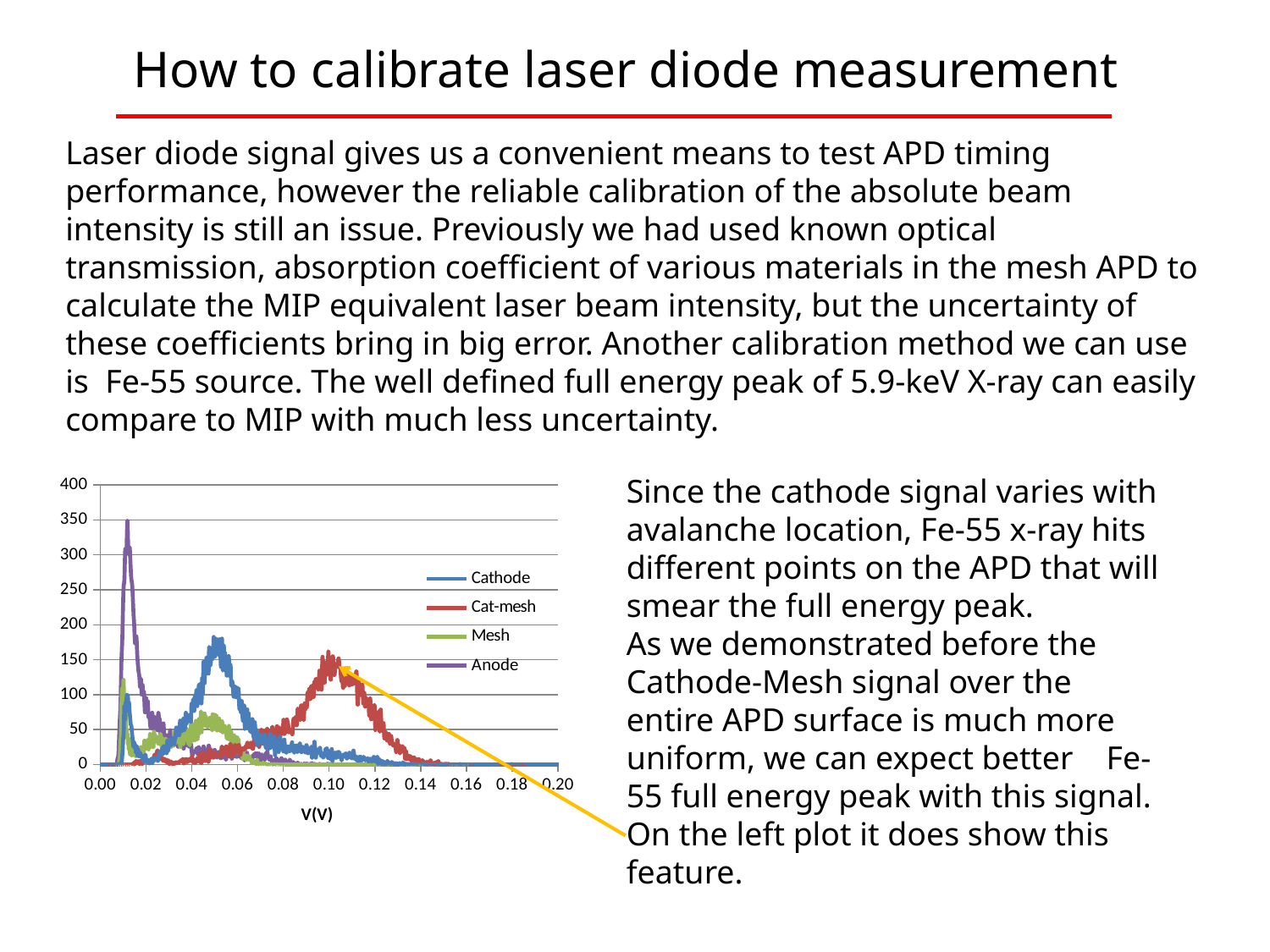
Is the peak value of the Cat-mesh series greater or less than 200? less What are the four series named in the chart's legend? Cathode, Cat-mesh, Mesh, Anode What is the label of the chart's x axis? V(V) Which series has its main peak at the largest V(V) value along the x axis? Cat-mesh Which series reaches the highest peak value in the chart? Anode Is the peak value of the Cat-mesh series greater or less than 100? greater Is the peak value of the Anode series greater or less than 300? greater What kind of chart is shown on the slide? line chart How many series does the chart's legend list? 4 Which series has the higher peak, Anode or Cathode? Anode